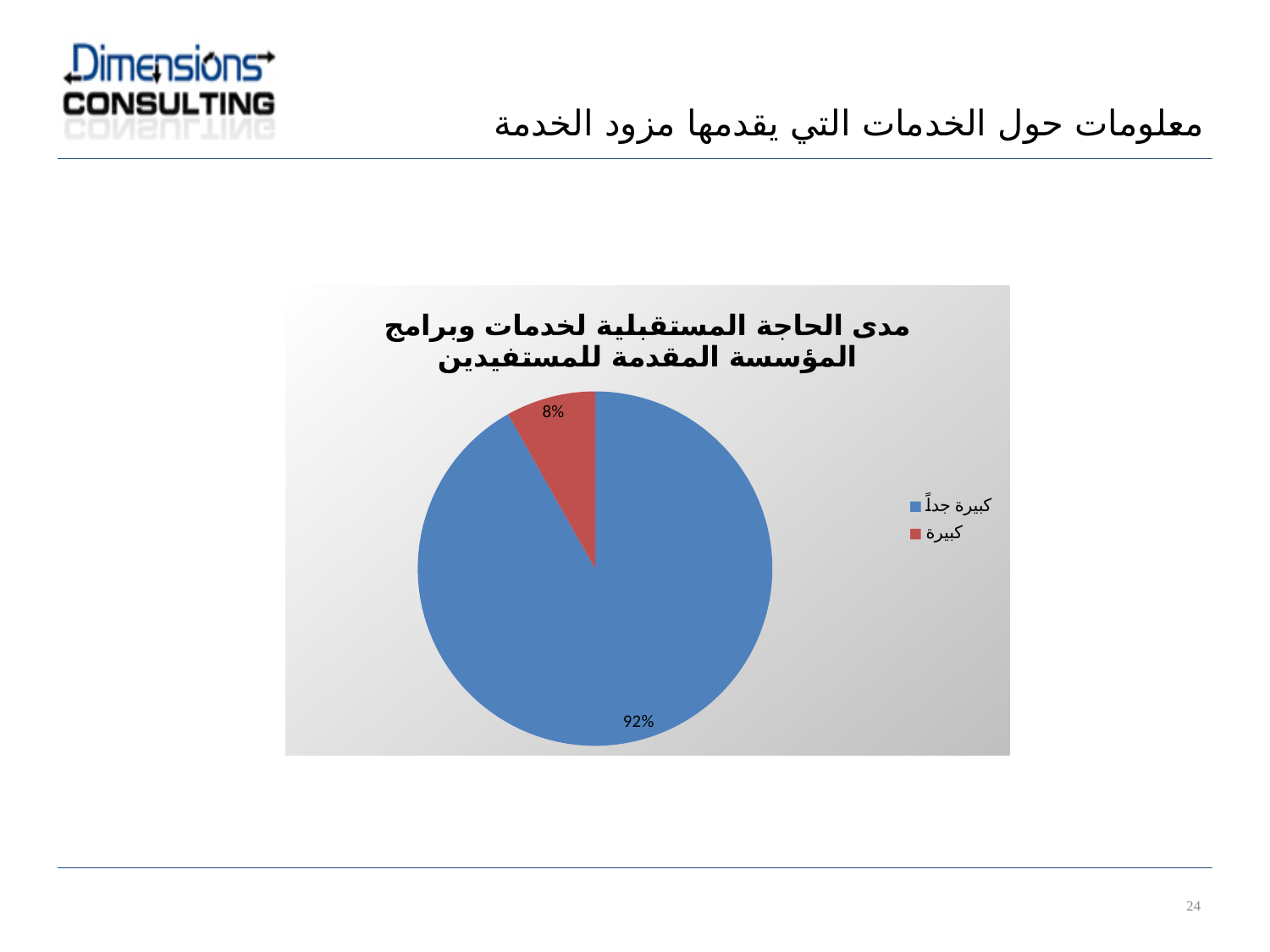
Which category has the largest slice of the pie? كبيرة جداً What kind of chart is shown on the slide? pie chart What is the difference in percentage points between the "كبيرة جداً" slice and the "كبيرة" slice? 84 How many entries does the legend list? 2 How many slices does the pie chart have? 2 Which category has the smallest slice of the pie? كبيرة Which slice is larger, "كبيرة جداً" or "كبيرة"? كبيرة جداً What colour is the "كبيرة" slice? red What is the title of the chart? مدى الحاجة المستقبلية لخدمات وبرامج المؤسسة المقدمة للمستفيدين What share of the pie does the "كبيرة جداً" slice represent? 92% What share of the pie does the "كبيرة" slice represent? 8%